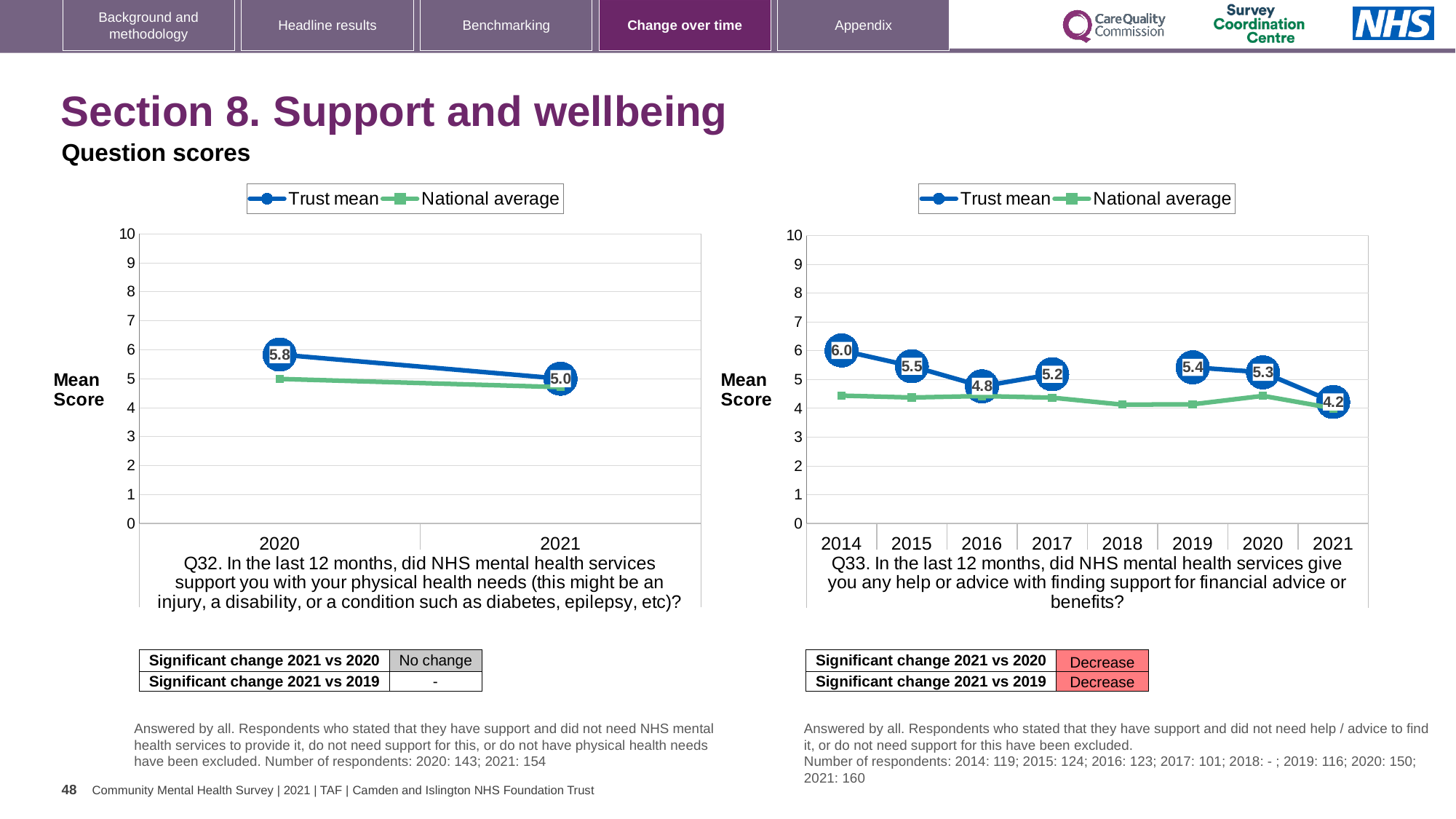
How many series does the legend of the right chart (Q33) list? 2 On the right chart (Q33), what is the Trust mean for 2014? 6.0 On the right chart (Q33), is the Trust mean higher in 2017 or in 2016? 2017 On the left chart (Q32), what is the Trust mean for 2021? 5.0 On the right chart (Q33), which year has the highest Trust mean? 2014 On the right chart (Q33), is the National average for 2018 greater or less than 5? less On the right chart (Q33), which year has the lowest Trust mean? 2021 On the left chart (Q32), what is the Trust mean for 2020? 5.8 On the right chart (Q33), what is the difference between the Trust mean in 2019 and in 2021? 1.2 On the left chart (Q32), does the Trust mean rise or fall from 2020 to 2021? fall On the right chart (Q33), what is the Trust mean for 2021? 4.2 On the left chart (Q32), what is the difference between the Trust mean in 2020 and in 2021? 0.8